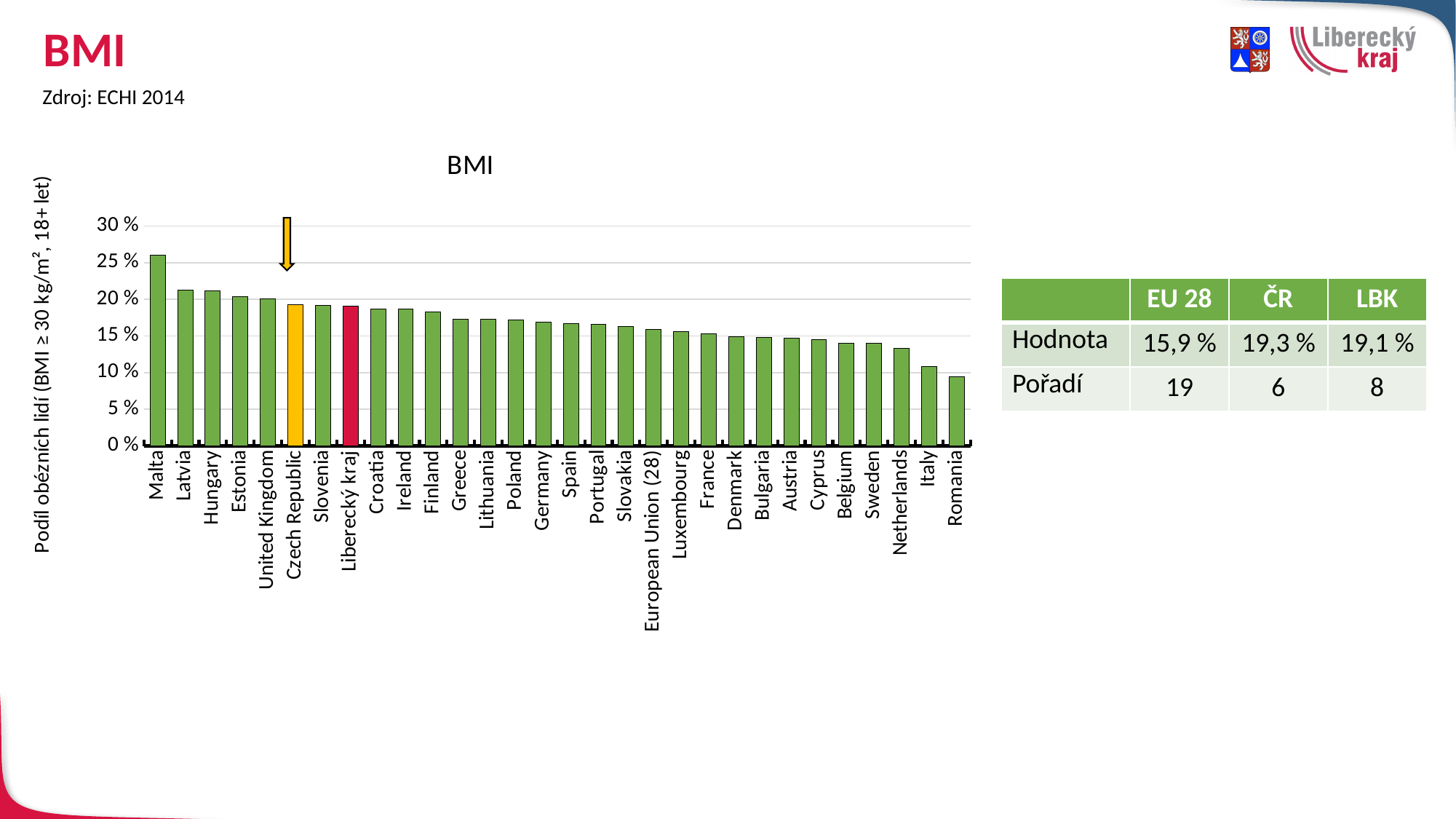
What is the value for European Union (28)? 15,9 % Which country has the highest share of obese people in the chart? Malta Is the value for Malta greater or less than 20 %? greater Which is larger, the value for Czech Republic or the value for European Union (28)? Czech Republic What is the difference between the values for Czech Republic and Liberecký kraj? 0,2 % What is the value for Liberecký kraj? 19,1 % What is the value for Czech Republic? 19,3 % What kind of chart is shown on the slide? bar chart Do the values rise or fall from left to right along the x axis? fall Which country has the lowest share of obese people in the chart? Romania Is the value for Italy greater or less than 15 %? less How many categories (bars) are plotted in the chart? 30